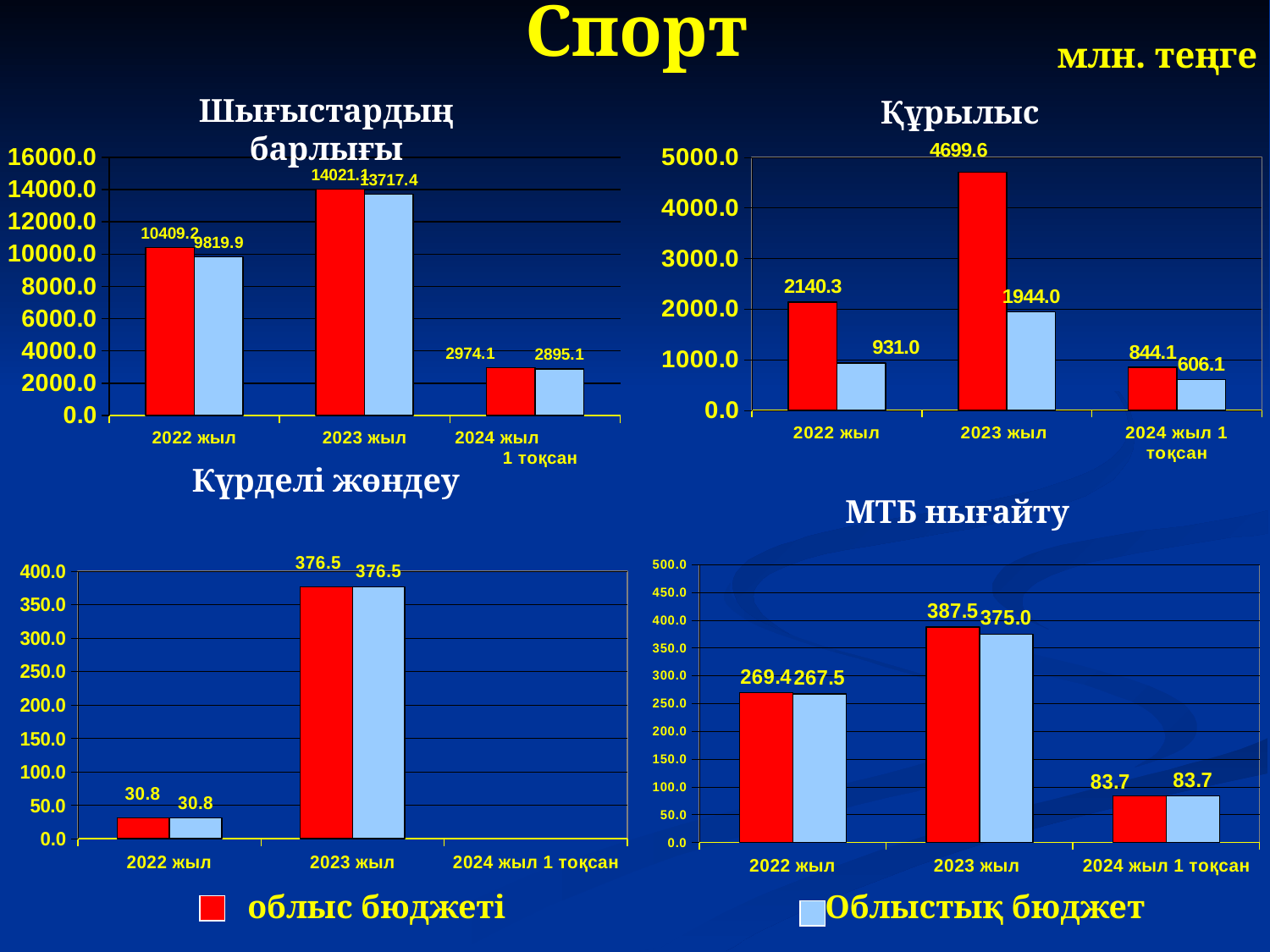
How many categories are shown on the x axis of the 'Күрделі жөндеу' chart? 3 In the 'Шығыстардың барлығы' chart, what is the difference between the red bars for 2023 жыл and 2022 жыл? 3611.9 In the 'Құрылыс' chart, what is the value of the red bar for 2023 жыл? 4699.6 How many series does the legend at the bottom of the slide list? 2 In the 'МТБ нығайту' chart, which is larger for 2023 жыл: the red bar or the light blue bar? the red bar In the 'Шығыстардың барлығы' chart, is the red bar for 2024 жыл 1 тоқсан greater or less than 4000.0? less In the 'Құрылыс' chart, which category has the lowest light blue bar? 2024 жыл 1 тоқсан In the 'Күрделі жөндеу' chart, which category has the highest values? 2023 жыл What type of chart is the 'МТБ нығайту' chart? bar chart In the 'Құрылыс' chart, what is the difference between the red and light blue bars for 2022 жыл? 1209.3 In the 'Шығыстардың барлығы' chart, what is the value of the light blue bar for 2022 жыл? 9819.9 In the 'МТБ нығайту' chart, what is the value of the red bar for 2024 жыл 1 тоқсан? 83.7